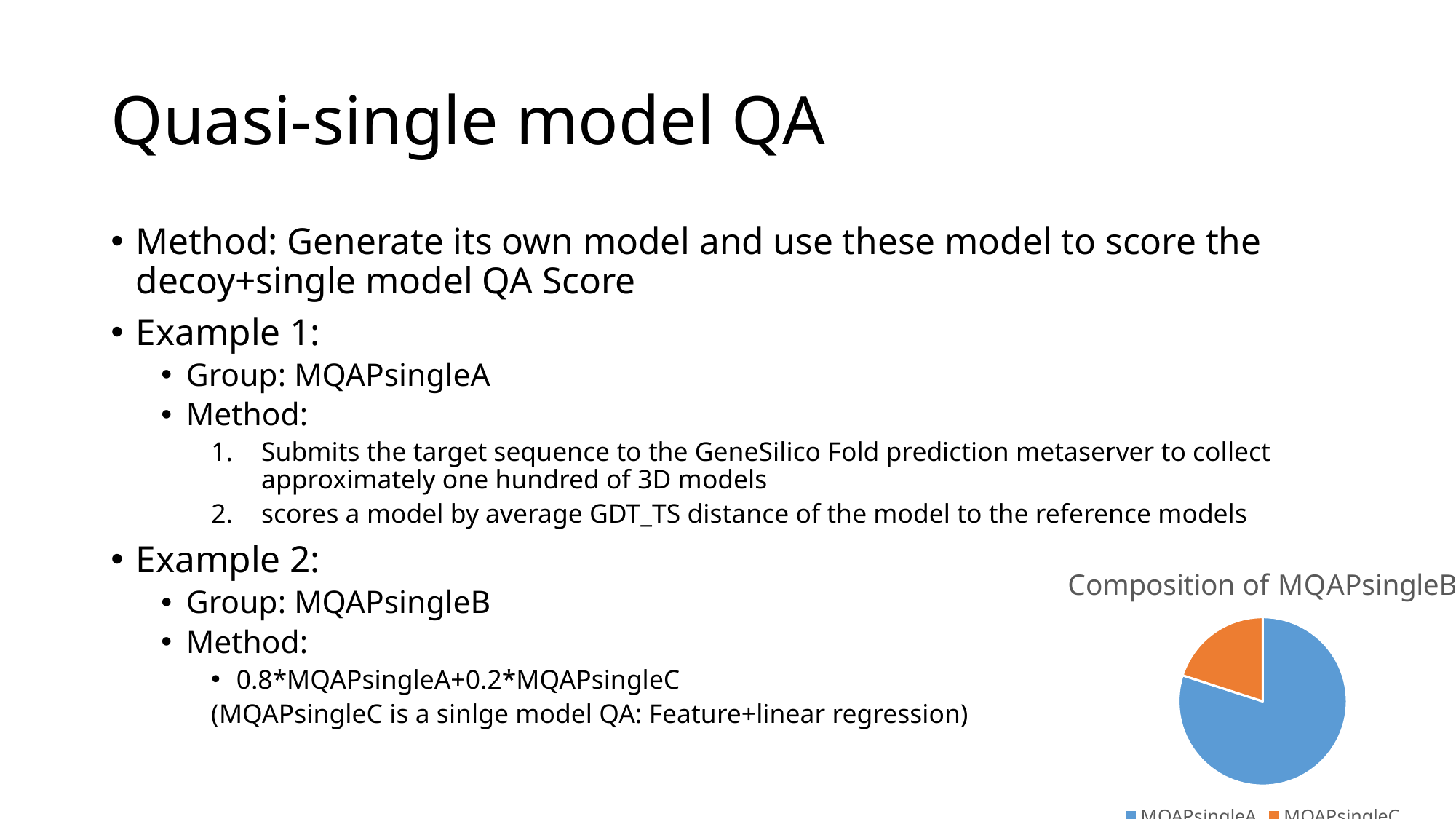
Which slice of the pie chart is the largest? MQAPsingleA Which legend entry in the pie chart is shown in orange? MQAPsingleC How many entries does the legend of the pie chart list? 2 What kind of chart is shown on the slide? pie chart Which slice of the pie chart is the smallest? MQAPsingleC In the pie chart, which is larger: the MQAPsingleA slice or the MQAPsingleC slice? MQAPsingleA What colour is the MQAPsingleA slice in the pie chart? blue What is the title of the pie chart? Composition of MQAPsingleB How many slices does the pie chart have? 2